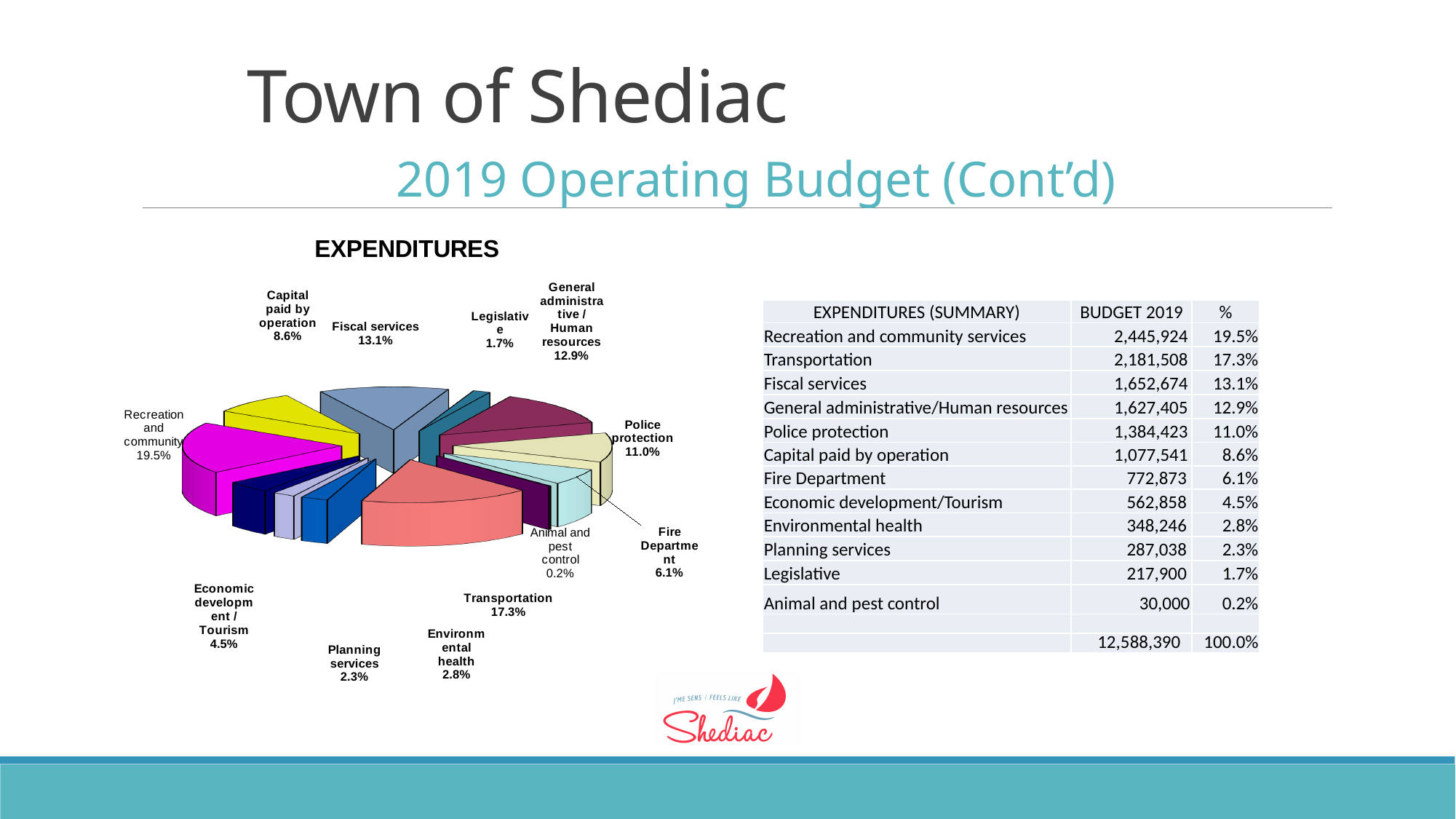
In the EXPENDITURES pie chart, what is the difference in percentage points between Recreation and community and Transportation? 2.2 In the EXPENDITURES pie chart, what share is labelled for Fire Department? 6.1% In the EXPENDITURES pie chart, what share is labelled for Capital paid by operation? 8.6% In the EXPENDITURES pie chart, what share is labelled for Transportation? 17.3% In the EXPENDITURES pie chart, which is larger: Fiscal services or General administrative / Human resources? Fiscal services What is the title of the pie chart on the slide? EXPENDITURES Which slice of the EXPENDITURES pie chart has the smallest share? Animal and pest control In the EXPENDITURES pie chart, what share is labelled for Police protection? 11.0% What type of chart is shown under the title EXPENDITURES? Pie chart In the EXPENDITURES pie chart, what share is labelled for Legislative? 1.7% How many slices does the EXPENDITURES pie chart have? 12 Which slice of the EXPENDITURES pie chart has the largest share? Recreation and community